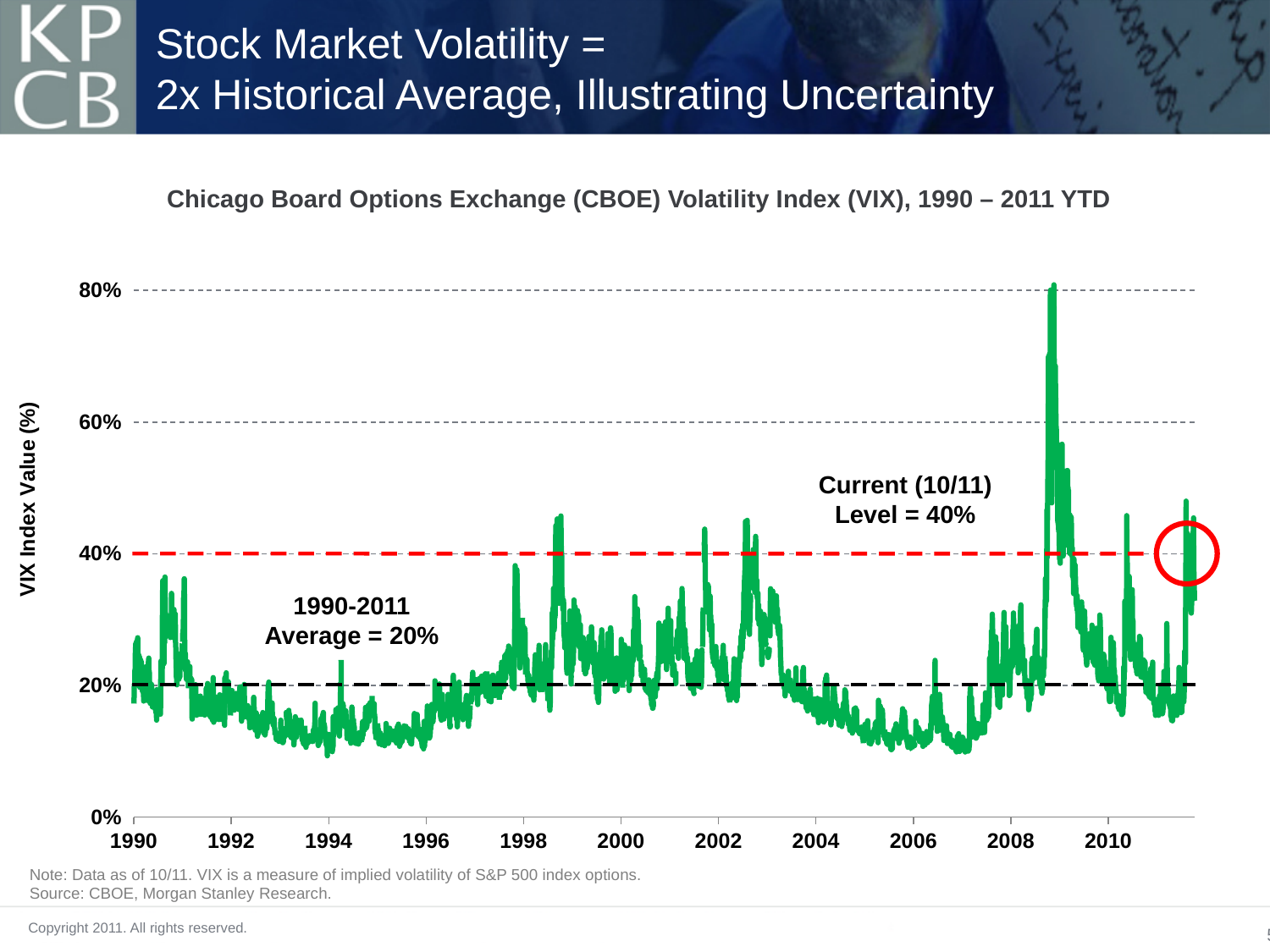
How many year labels are shown on the x axis? 11 What is the current (10/11) level of the VIX according to the annotation? 40% Is the VIX value around 2006 greater or less than 20%? less Is the highest peak of the VIX line closer to the 2008 or the 2010 x-axis label? 2008 By how much does the current (10/11) level exceed the 1990-2011 average? 20% What is the label of the y axis? VIX Index Value (%) Do VIX values generally rise or fall between 2003 and 2006? fall Is the highest peak of the VIX line greater or less than 60%? greater What kind of chart is shown on the slide? line chart Is the current (10/11) level higher or lower than the 1990-2011 average? higher What is the 1990-2011 average VIX level according to the annotation? 20% What colour is the dashed line marking the current (10/11) level? red